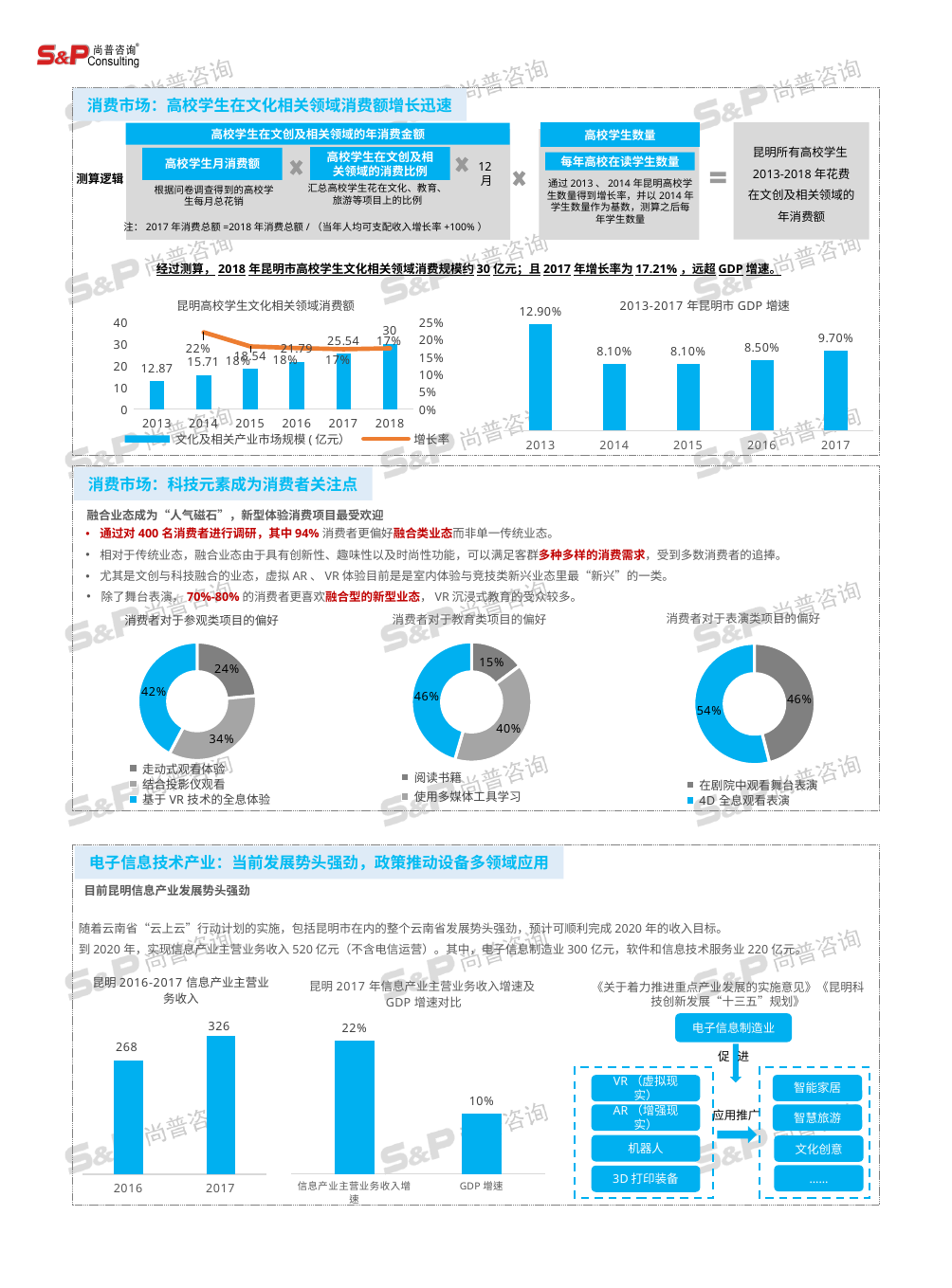
In the chart titled 昆明 2016-2017 年信息产业主营业务收入, what is the value for 2017? 326 In the donut chart titled 消费者对于参观类项目的偏好, what share is 基于 VR 技术的全息体验? 42% In the chart titled 昆明高校学生文化相关领域消费额, what is the difference between the 2017 and 2016 values of 文化及相关产业市场规模（亿元）? 3.75 In the chart titled 昆明 2017 年信息产业主营业务收入增速及 GDP 增速对比, which is larger, 信息产业主营业务收入增速 or GDP 增速? 信息产业主营业务收入增速 In the chart titled 昆明高校学生文化相关领域消费额, how many series does the legend list? 2 In the chart titled 昆明高校学生文化相关领域消费额, what is the value of 文化及相关产业市场规模（亿元） for 2013? 12.87 In the chart titled 2013-2017 年昆明市 GDP 增速, how many years are shown? 5 In the chart titled 昆明高校学生文化相关领域消费额, what is the value of 文化及相关产业市场规模（亿元） for 2018? 30 In the chart titled 2013-2017 年昆明市 GDP 增速, what is the value for 2017? 9.70% In the chart titled 昆明高校学生文化相关领域消费额, do the bar values rise or fall from 2013 to 2018? rise In the chart titled 2013-2017 年昆明市 GDP 增速, which year has the highest value? 2013 In the donut chart titled 消费者对于教育类项目的偏好, what is the smallest slice's value? 15%